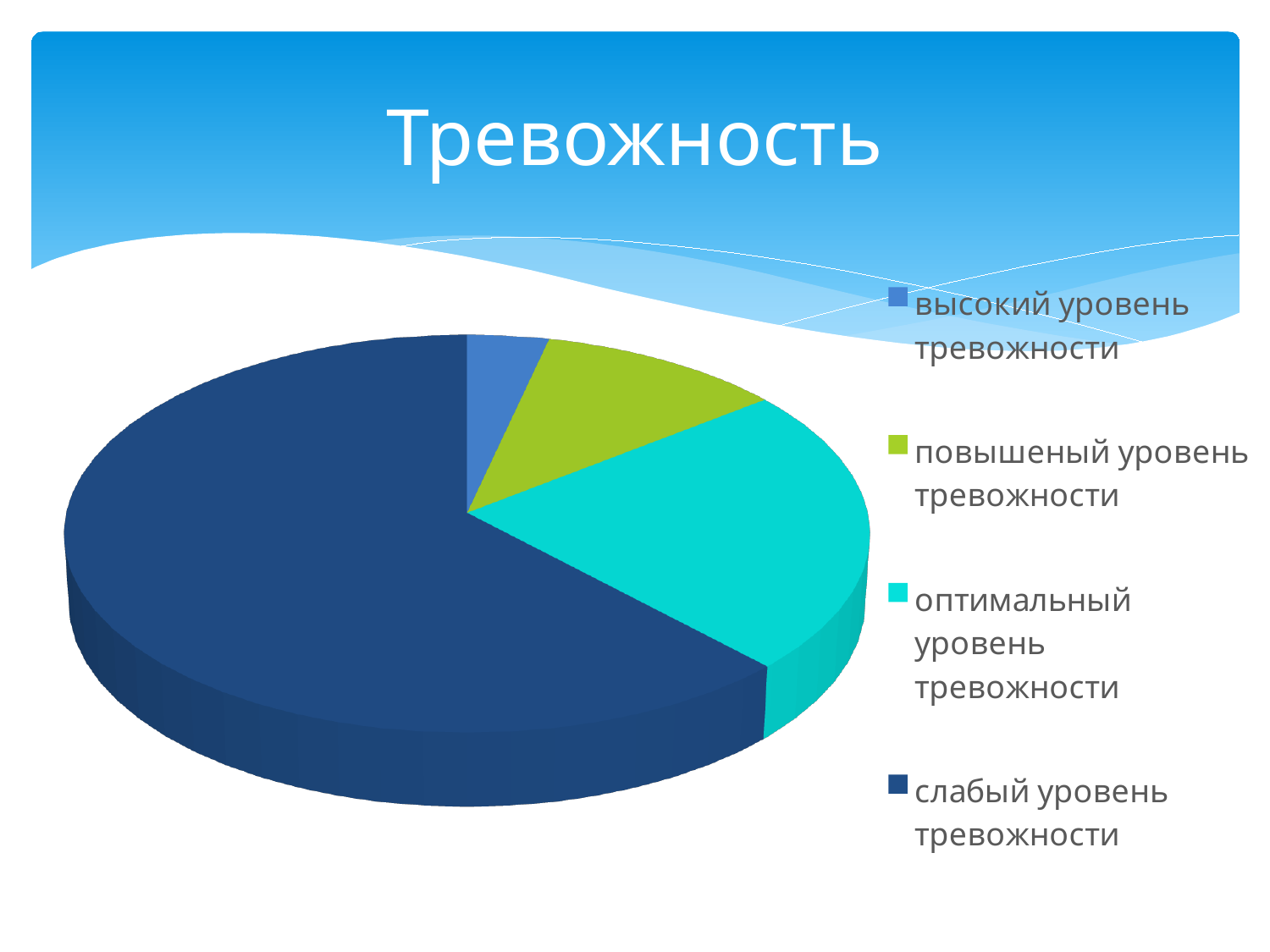
How many categories (slices) does the pie chart have? 4 How many entries does the legend list? 4 Which category has the largest slice of the pie? слабый уровень тревожности Which category is shown in dark blue on the pie chart? слабый уровень тревожности Which slice is larger: слабый уровень тревожности or оптимальный уровень тревожности? слабый уровень тревожности Which category has the smallest slice of the pie? высокий уровень тревожности What kind of chart is shown on the slide? pie chart What is the title of the chart on the slide? Тревожность Which slice is larger: оптимальный уровень тревожности or повышеный уровень тревожности? оптимальный уровень тревожности Which slice is larger: повышеный уровень тревожности or высокий уровень тревожности? повышеный уровень тревожности Does the slice for слабый уровень тревожности take up more or less than half of the pie? more